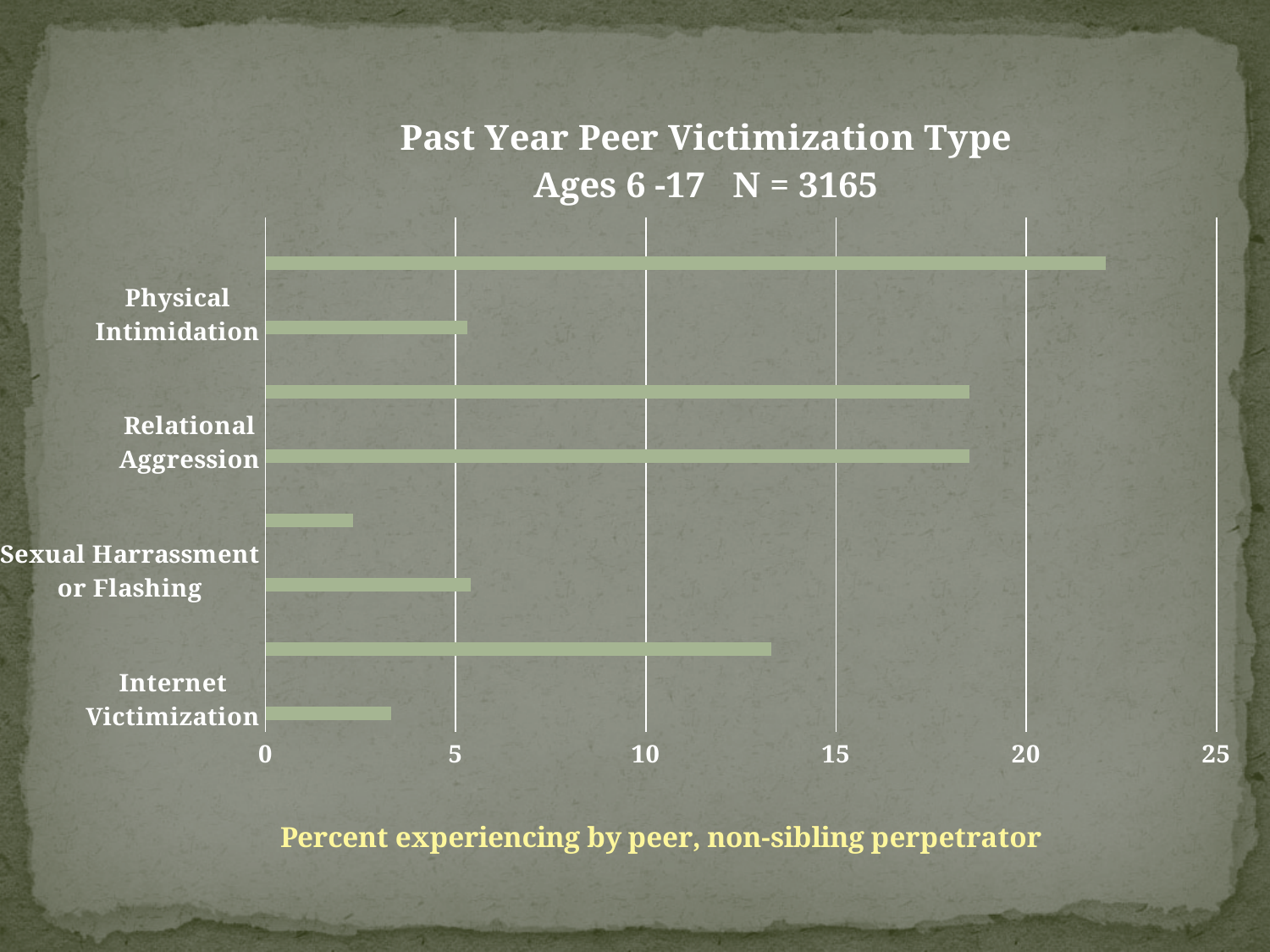
Which bar is longer, the topmost bar or the bottommost bar? the topmost bar What is the title of the chart? Past Year Peer Victimization Type Ages 6 -17 N = 3165 Is the value of the shortest bar in the chart greater or less than 5? less How many bars are plotted in the chart? 8 What is the label on the horizontal axis of the chart? Percent experiencing by peer, non-sibling perpetrator Is the value of the bottommost bar greater or less than 5? less Is the value of the topmost bar greater or less than 15? greater What kind of chart is shown on the slide? bar chart How many category labels are printed along the vertical axis of the chart? 4